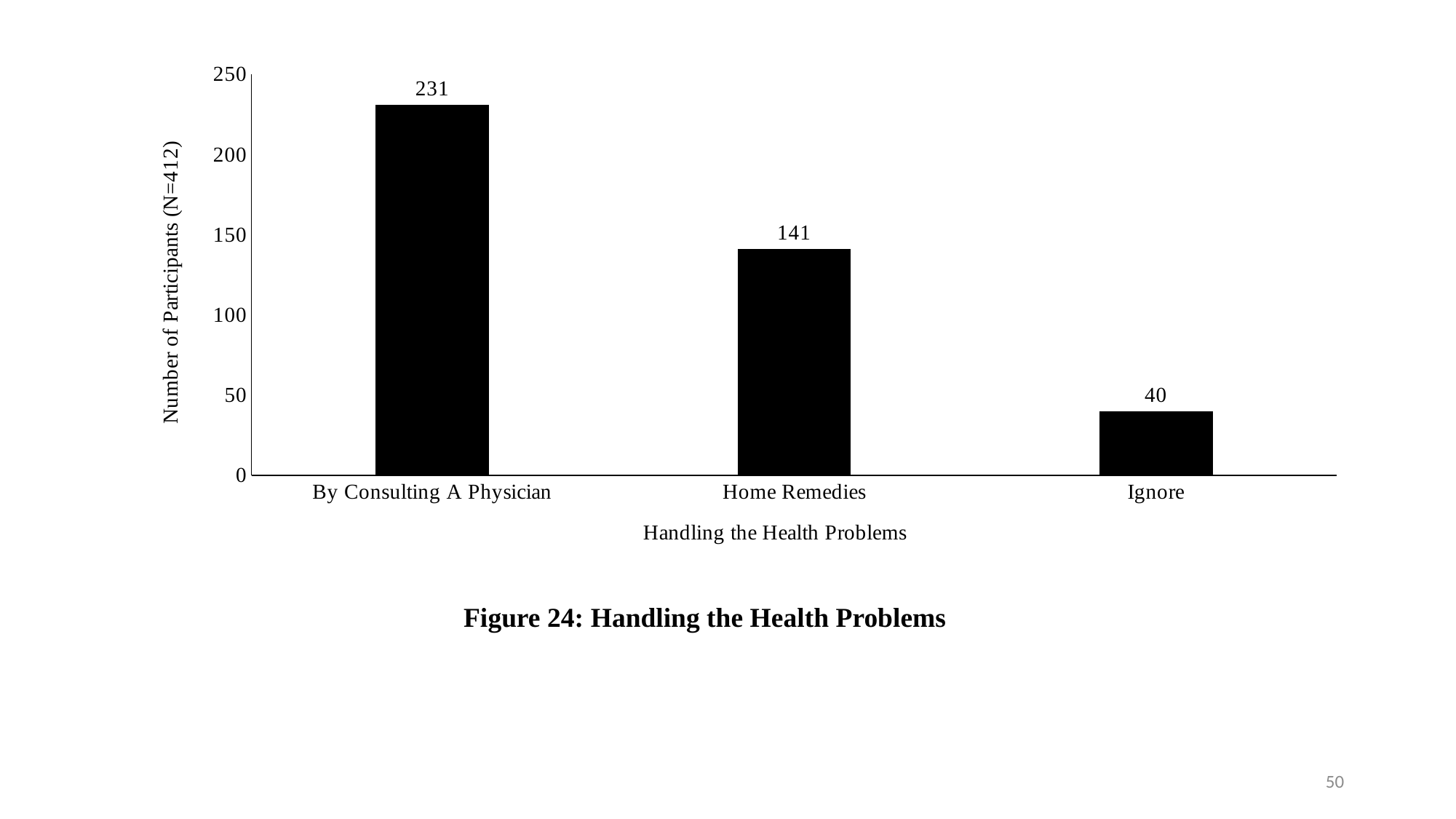
Which category has the highest number of participants? By Consulting A Physician How many participants handle health problems by consulting a physician? 231 What is the difference in participants between Home Remedies and Ignore? 101 What kind of chart is shown on the slide? Bar chart How many categories are shown on the x axis? 3 Is the value for Home Remedies greater or less than 100? greater What is the label of the y axis? Number of Participants (N=412) What is the difference in participants between By Consulting A Physician and Home Remedies? 90 What is the number of participants for Ignore? 40 Which has more participants, Home Remedies or Ignore? Home Remedies What is the number of participants for Home Remedies? 141 Which category has the lowest number of participants? Ignore